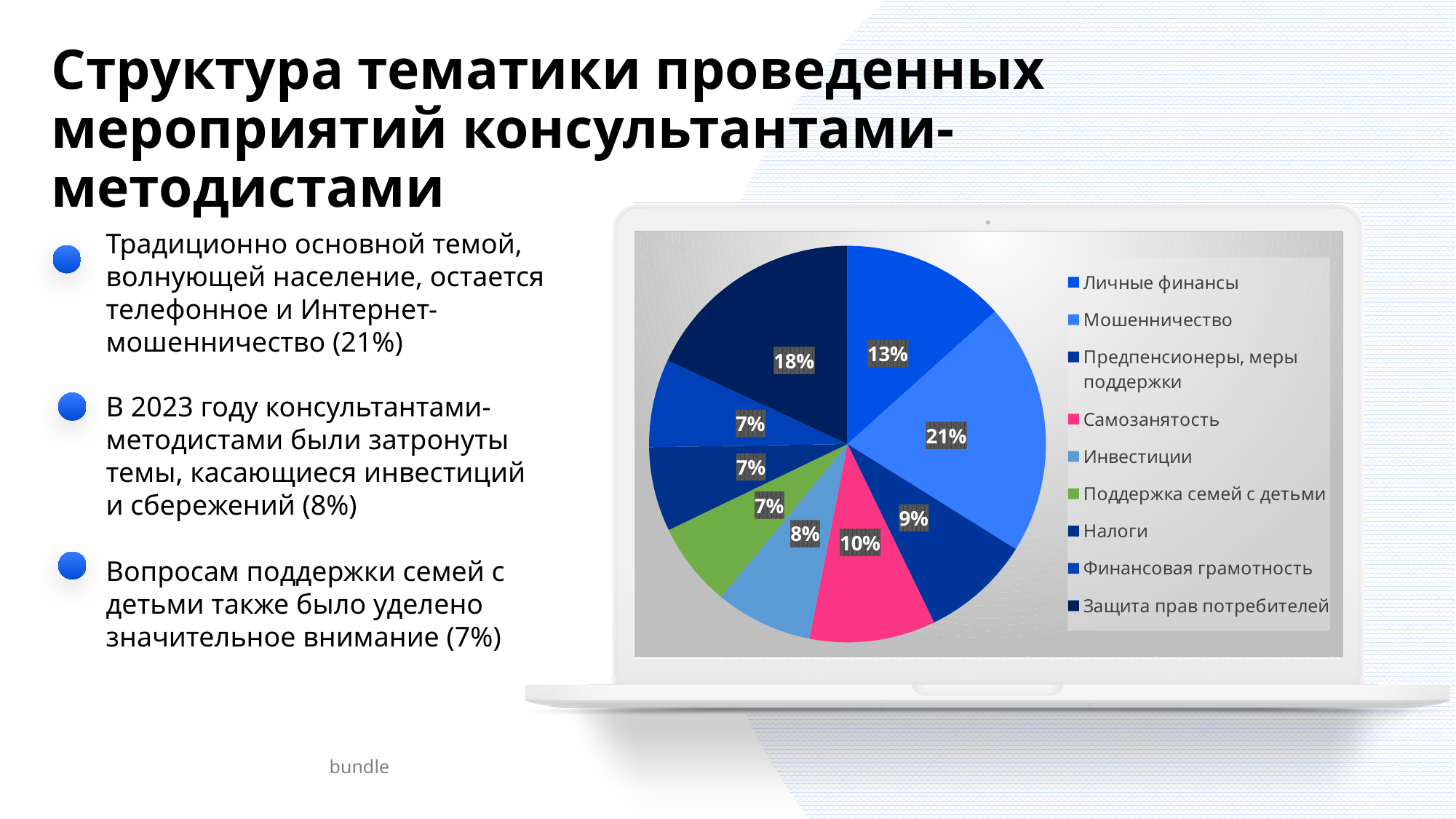
What is the value shown for Поддержка семей с детьми? 7% Which is larger, the share for Самозанятость or the share for Инвестиции? Самозанятость What kind of chart is shown on the slide? pie chart What is the value shown for Личные финансы? 13% What share of the pie does Мошенничество have? 21% Which legend entry is shown in pink? Самозанятость What is the value shown for Инвестиции? 8% Which category has the largest share of the pie? Мошенничество What is the difference in percentage points between Мошенничество and Личные финансы? 8 How many entries does the legend of the pie chart list? 9 How many slices does the pie chart have? 9 What is the value shown for Самозанятость? 10%